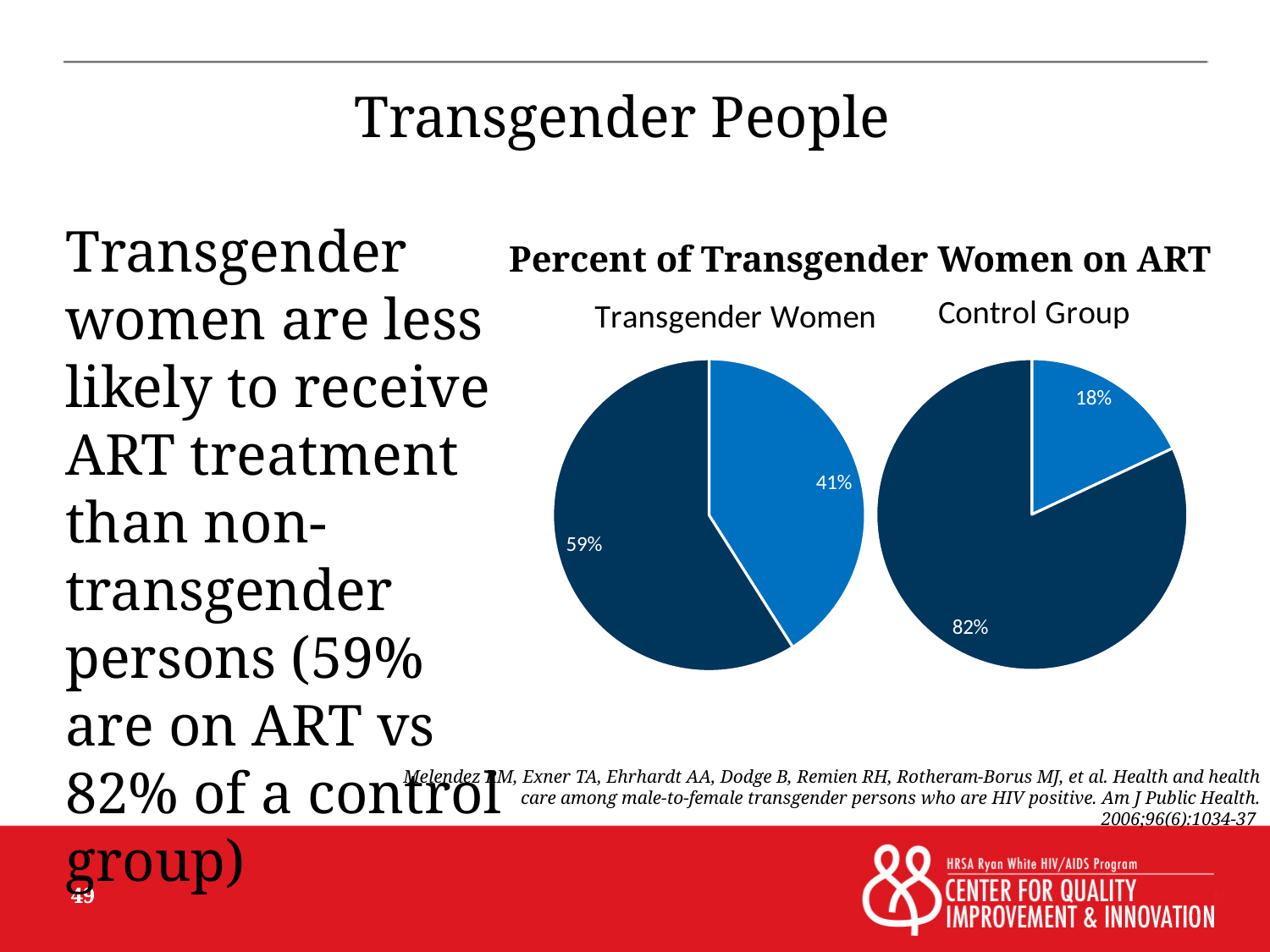
In the Control Group pie chart, what is the value of the smaller (light blue) slice? 18% How many slices does each pie chart have? 2 What kind of charts are shown on the slide? Pie charts Which pie chart has the larger dark blue slice, Transgender Women or Control Group? Control Group In the Transgender Women pie chart, what is the difference between the two slices? 18% How many pie charts are on the slide? 2 In the Transgender Women pie chart, what is the value of the smaller (light blue) slice? 41% What is the overall title above the two pie charts? Percent of Transgender Women on ART In the Transgender Women pie chart, what is the value of the larger (dark blue) slice? 59% What is the difference between the dark blue slice in the Control Group pie chart (82%) and the dark blue slice in the Transgender Women pie chart (59%)? 23% In the Control Group pie chart, what is the value of the larger (dark blue) slice? 82% What is the title of the pie chart on the right? Control Group